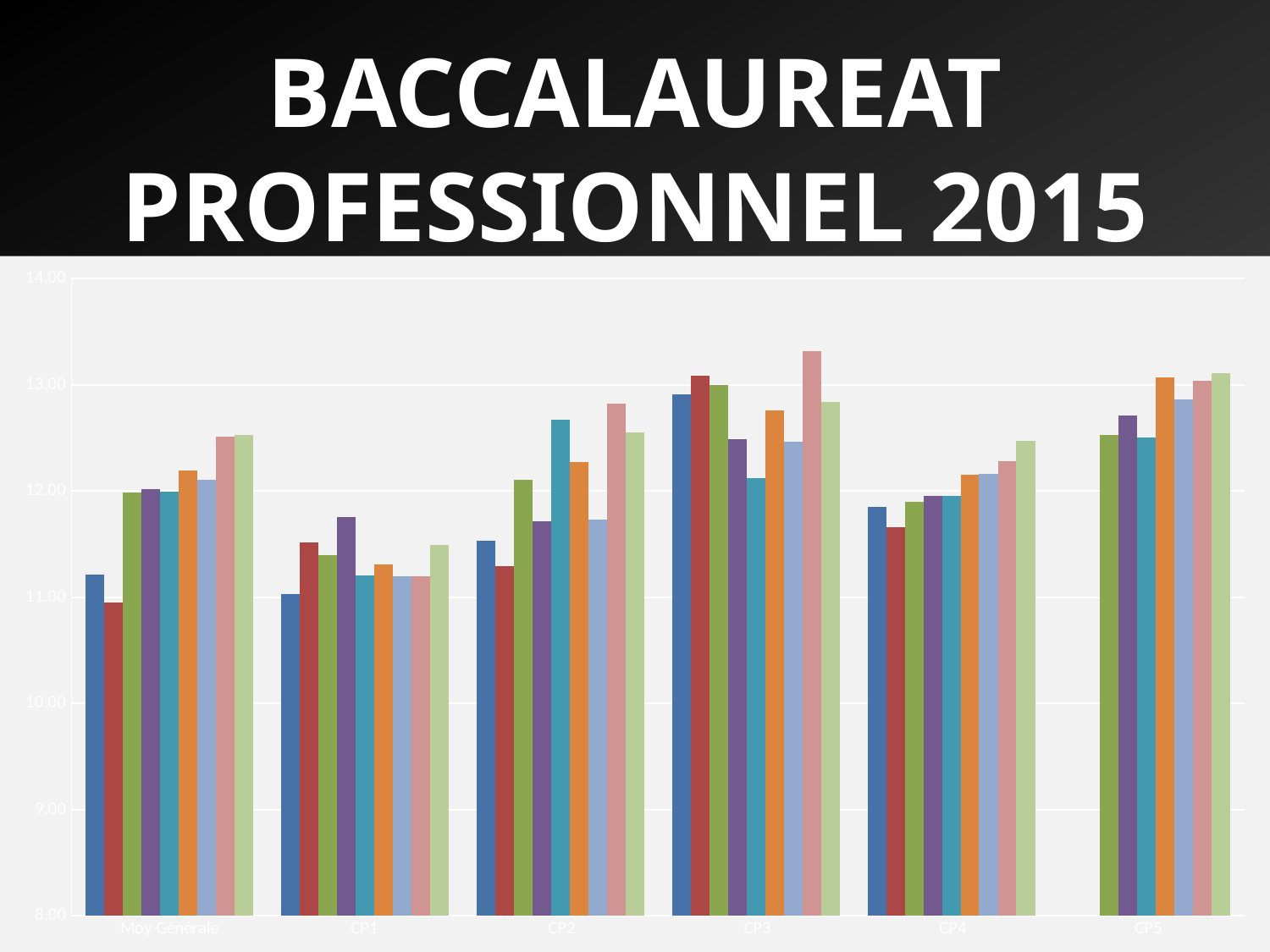
Is the value of the pink bar in the CP3 group greater or less than 13.00? greater What kind of chart is shown on the slide? bar chart Is the tallest bar in the CP1 group greater or less than 12.00? less How many bars are shown in the CP5 group? 7 How many categories are shown along the x axis of the chart? 6 Is the value of the first (blue) bar in the Moy Générale group greater or less than 12.00? less What are the lowest and highest values shown on the chart's y axis? 8.00 and 14.00 Which is larger: the first (blue) bar in CP3 or the first (blue) bar in CP1? CP3 Which is larger: the red bar in CP3 or the red bar in Moy Générale? CP3 What is the title shown above the chart? BACCALAUREAT PROFESSIONNEL 2015